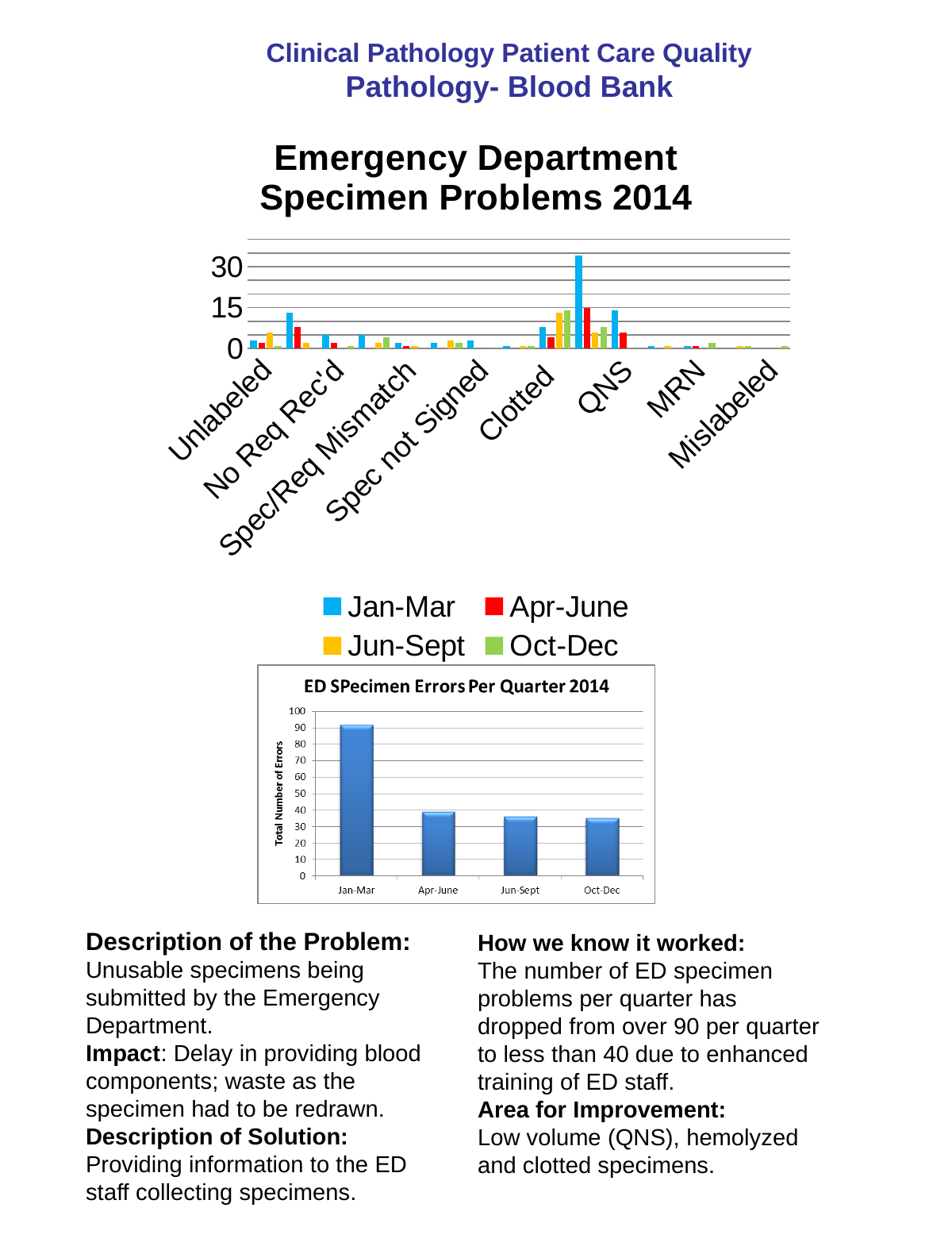
In the 'Emergency Department Specimen Problems 2014' chart, which series is shown in blue? Jan-Mar In the 'ED SPecimen Errors Per Quarter 2014' chart, which quarter has the highest number of errors? Jan-Mar How many quarters are shown on the x axis of the 'ED SPecimen Errors Per Quarter 2014' chart? 4 How many series does the legend of the 'Emergency Department Specimen Problems 2014' chart list? 4 In the 'ED SPecimen Errors Per Quarter 2014' chart, is the value for Apr-June greater or less than 50? less In the 'Emergency Department Specimen Problems 2014' chart, is the tallest bar greater or less than 30? greater In the 'ED SPecimen Errors Per Quarter 2014' chart, is the value for Oct-Dec greater or less than 40? less What is the y-axis title of the 'ED SPecimen Errors Per Quarter 2014' chart? Total Number of Errors In the 'ED SPecimen Errors Per Quarter 2014' chart, do the values rise or fall from Jan-Mar to Oct-Dec? fall In the 'ED SPecimen Errors Per Quarter 2014' chart, which is larger, Jan-Mar or Apr-June? Jan-Mar What kind of chart is the 'ED SPecimen Errors Per Quarter 2014' chart? bar chart